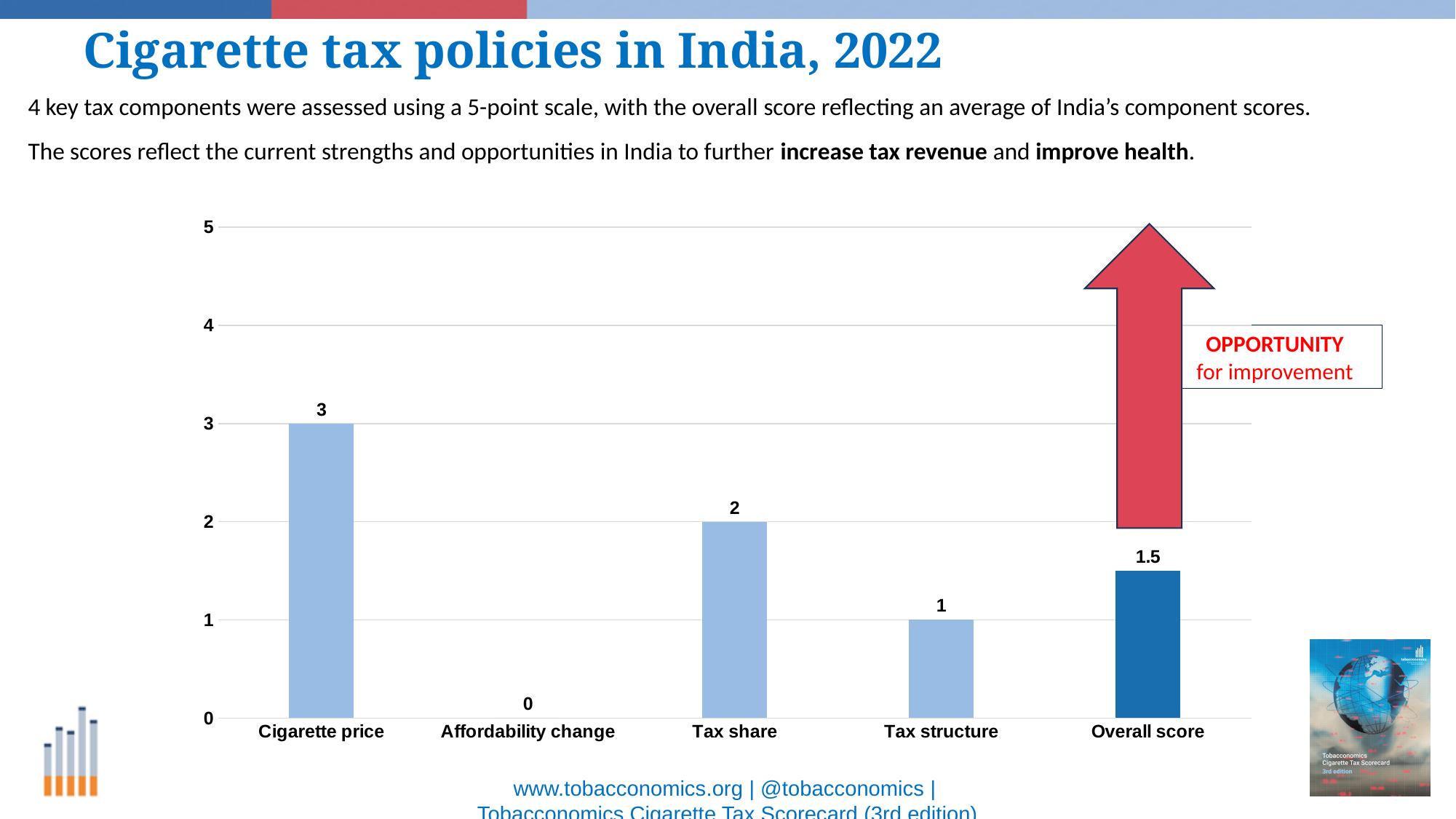
How many categories are shown on the x axis? 5 What is the score for Tax share? 2 What text appears in the box next to the red arrow? OPPORTUNITY for improvement Which category has the lowest score? Affordability change What kind of chart is shown on the slide? Bar chart What is the score for Cigarette price? 3 Which is larger, the Tax structure score or the Overall score? Overall score What is the score for Affordability change? 0 Which category has the highest score? Cigarette price What is the Overall score? 1.5 What is the difference between the Cigarette price score and the Tax share score? 1 What is the score for Tax structure? 1